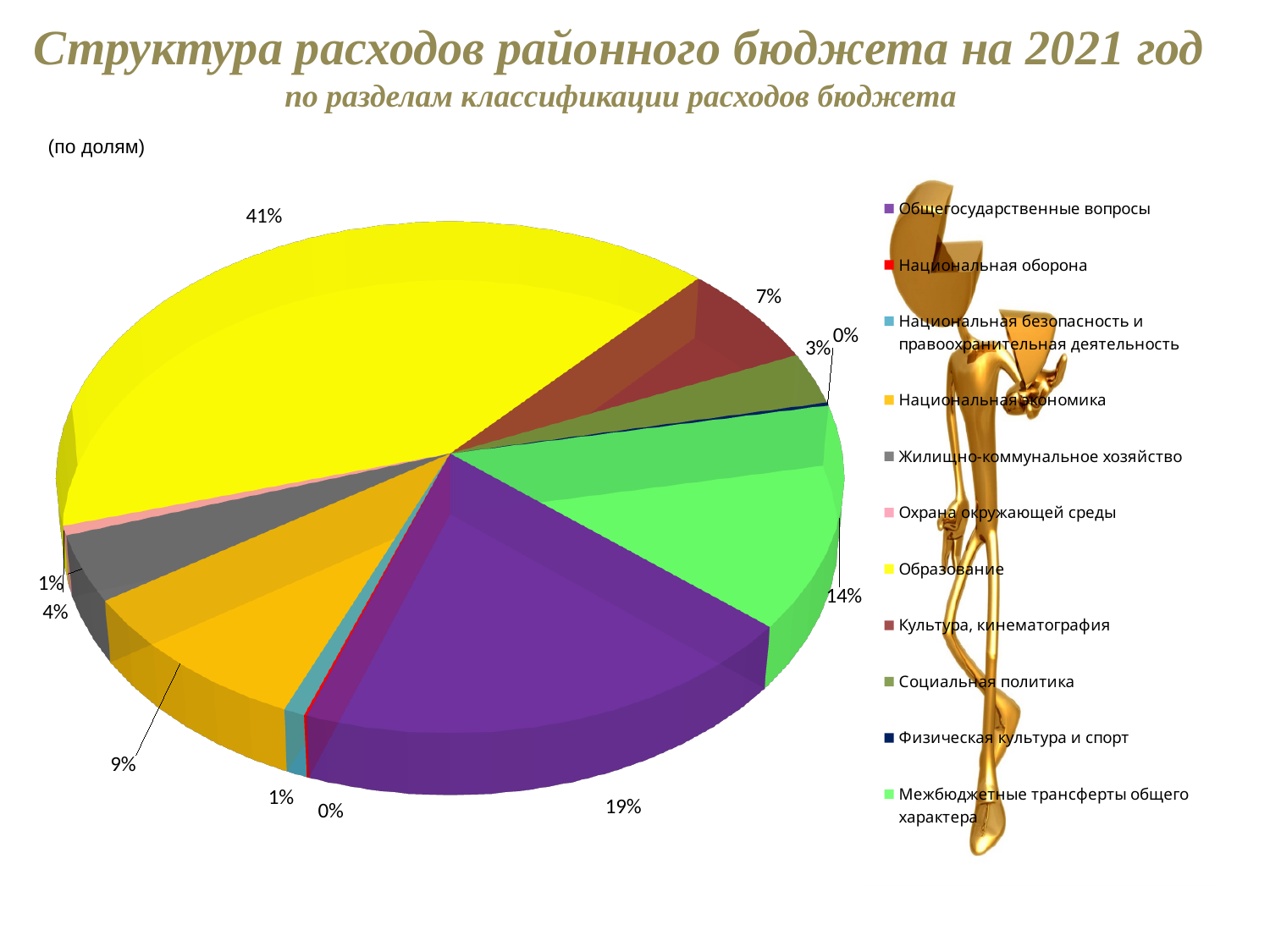
What is the difference between the share for Образование and the share for Общегосударственные вопросы? 22% What share is shown for Культура, кинематография? 7% Which category has the largest share of the pie? Образование How many categories does the legend list? 11 What share of the budget expenditure goes to Образование? 41% What share is shown for Общегосударственные вопросы? 19% What share is shown for Межбюджетные трансферты общего характера? 14% What kind of chart is shown on the slide? pie chart What colour is the slice for Образование? yellow What share is shown for Жилищно-коммунальное хозяйство? 4% Which is larger, the share for Общегосударственные вопросы or the share for Межбюджетные трансферты общего характера? Общегосударственные вопросы What share is shown for Национальная экономика? 9%